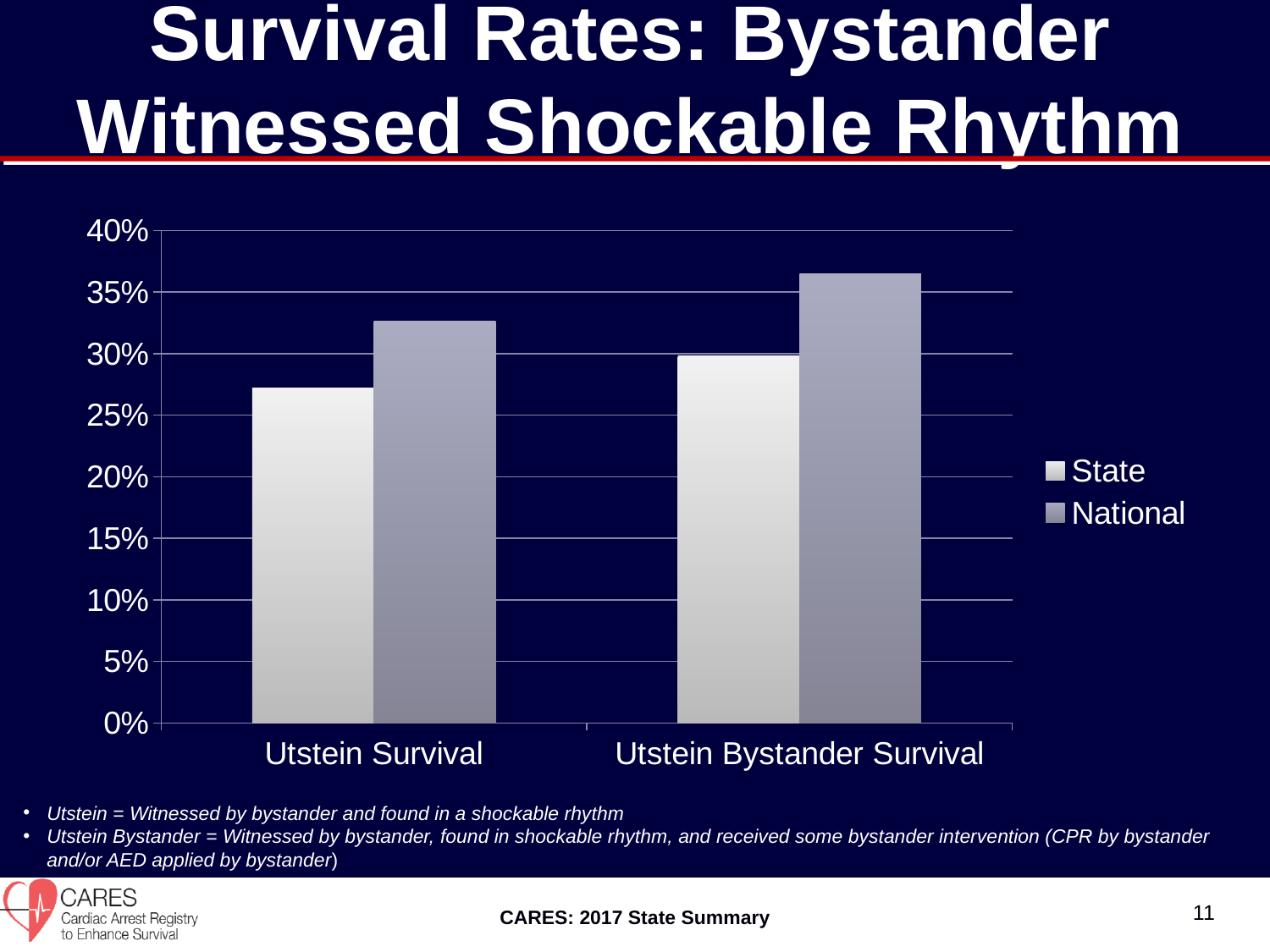
Which bar is the shortest in the chart? State, Utstein Survival Is the State value for Utstein Survival greater or less than 25%? greater What is the title of the chart on the slide? Survival Rates: Bystander Witnessed Shockable Rhythm Which series has the higher value for Utstein Survival, State or National? National How many series does the legend list? 2 How many categories are shown on the x axis? 2 Is the State value for Utstein Survival greater or less than 30%? less Is the National value for Utstein Bystander Survival greater or less than 35%? greater Which series has the higher value for Utstein Bystander Survival, State or National? National Which bar is the tallest in the chart? National, Utstein Bystander Survival What type of chart is shown on the slide? Bar chart